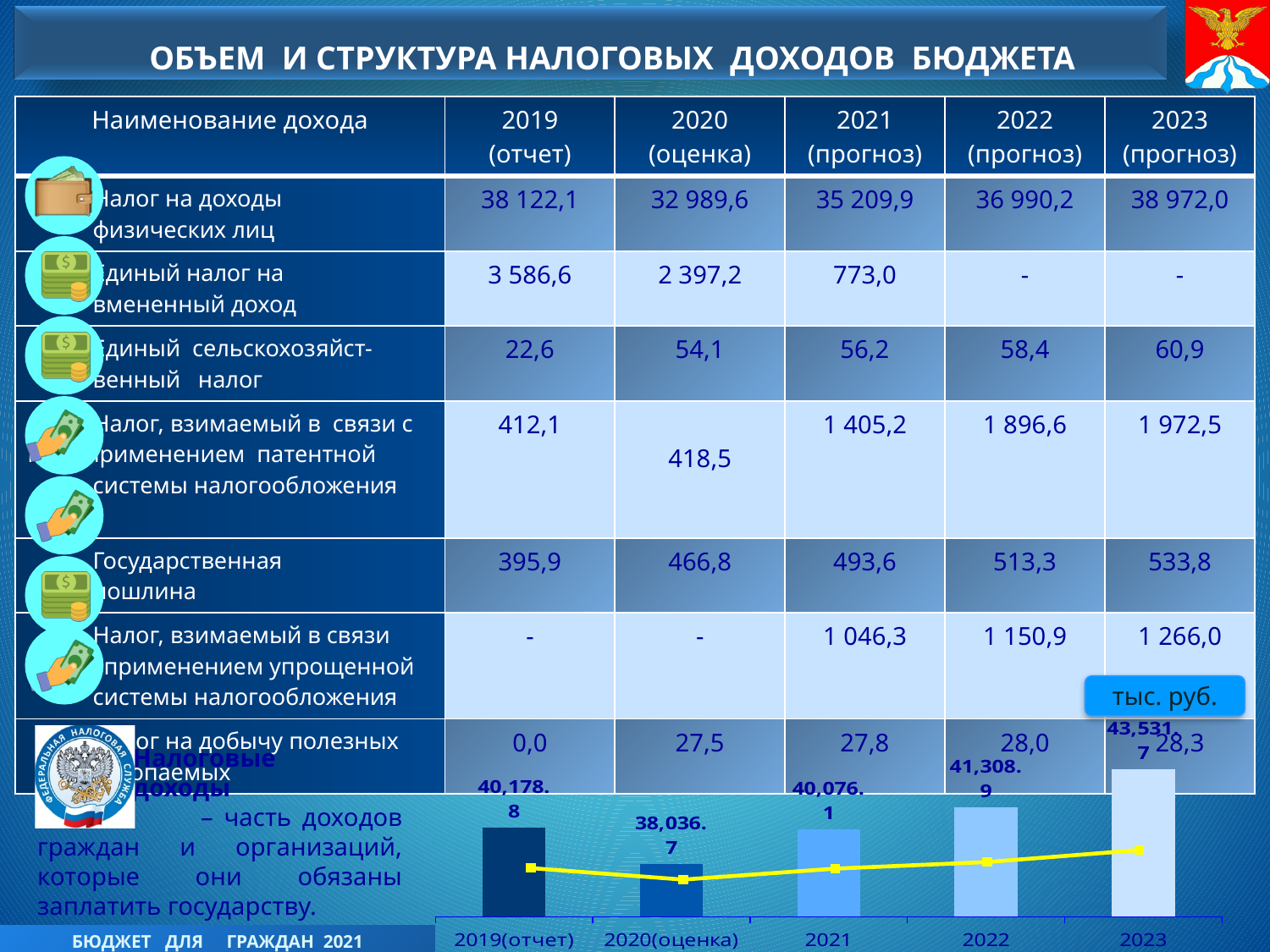
What kind of chart is shown at the bottom of the slide? bar chart In the bar chart at the bottom of the slide, what is the difference between the values for 2023 and 2019(отчет)? 3,352.9 In the bar chart at the bottom of the slide, what is the value for 2021? 40,076.1 In the bar chart at the bottom of the slide, which year has the lowest value? 2020(оценка) In the bar chart at the bottom of the slide, what is the value for 2020(оценка)? 38,036.7 In the bar chart at the bottom of the slide, do the values rise or fall from 2020(оценка) to 2023? rise In the bar chart at the bottom of the slide, what is the value for 2019(отчет)? 40,178.8 How many categories (years) are shown in the bar chart at the bottom of the slide? 5 In the bar chart at the bottom of the slide, which is larger: the value for 2019(отчет) or the value for 2021? 2019(отчет) In the bar chart at the bottom of the slide, what is the value for 2022? 41,308.9 In the bar chart at the bottom of the slide, which year has the highest value? 2023 In the bar chart at the bottom of the slide, what is the value for 2023? 43,531.7